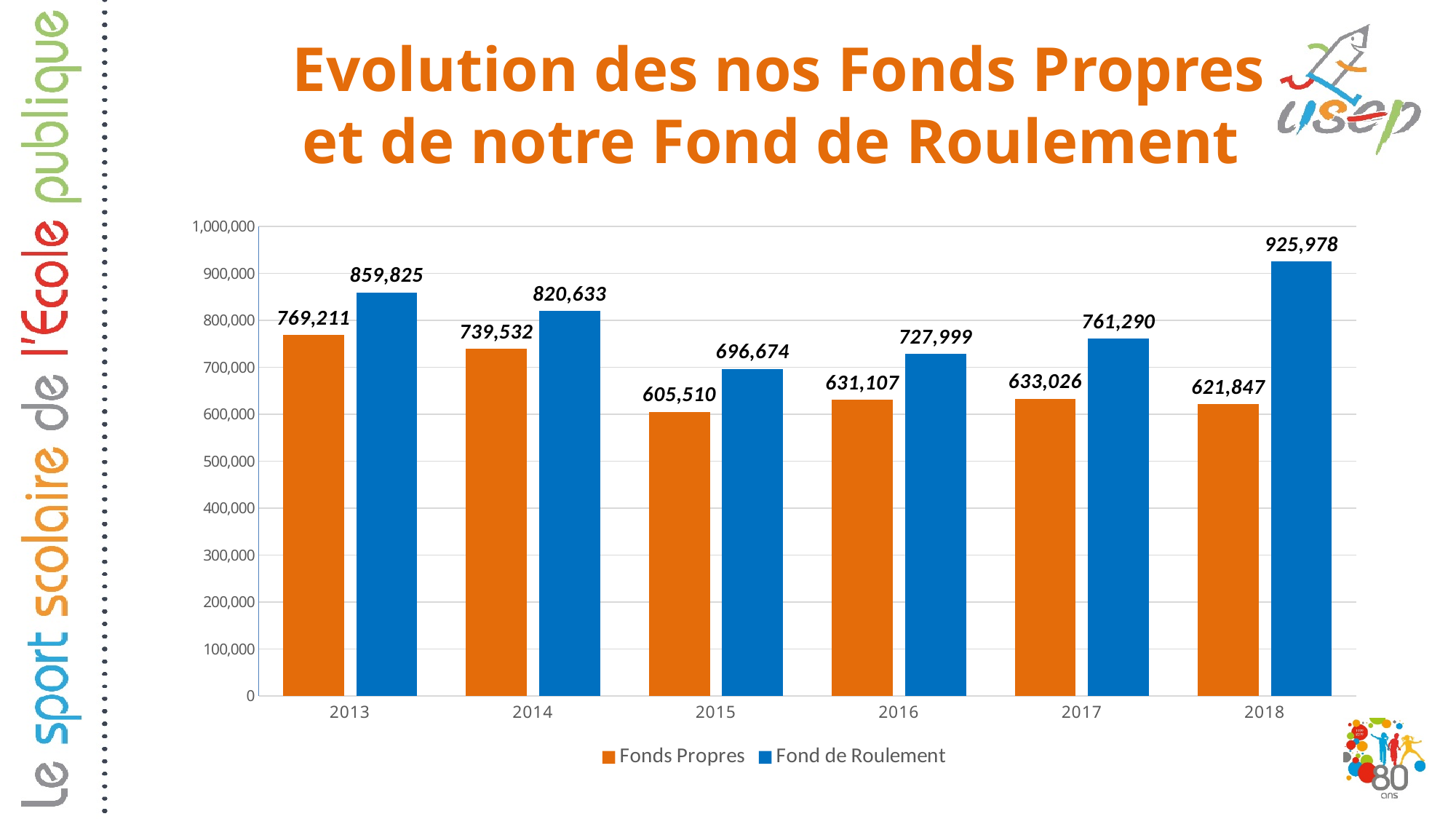
What kind of chart is shown on the slide? Bar chart What is the value of Fond de Roulement for 2018? 925,978 In which year is Fonds Propres the lowest? 2015 How many series does the legend list? 2 How many years are shown on the x axis? 6 In which year is Fond de Roulement the highest? 2018 Which colour represents Fond de Roulement in the chart? Blue What is the value of Fonds Propres for 2013? 769,211 Which is larger, Fond de Roulement in 2014 or Fond de Roulement in 2017? Fond de Roulement in 2014 What is the value of Fond de Roulement for 2016? 727,999 What is the difference between Fond de Roulement and Fonds Propres in 2018? 304,131 What is the value of Fonds Propres for 2015? 605,510